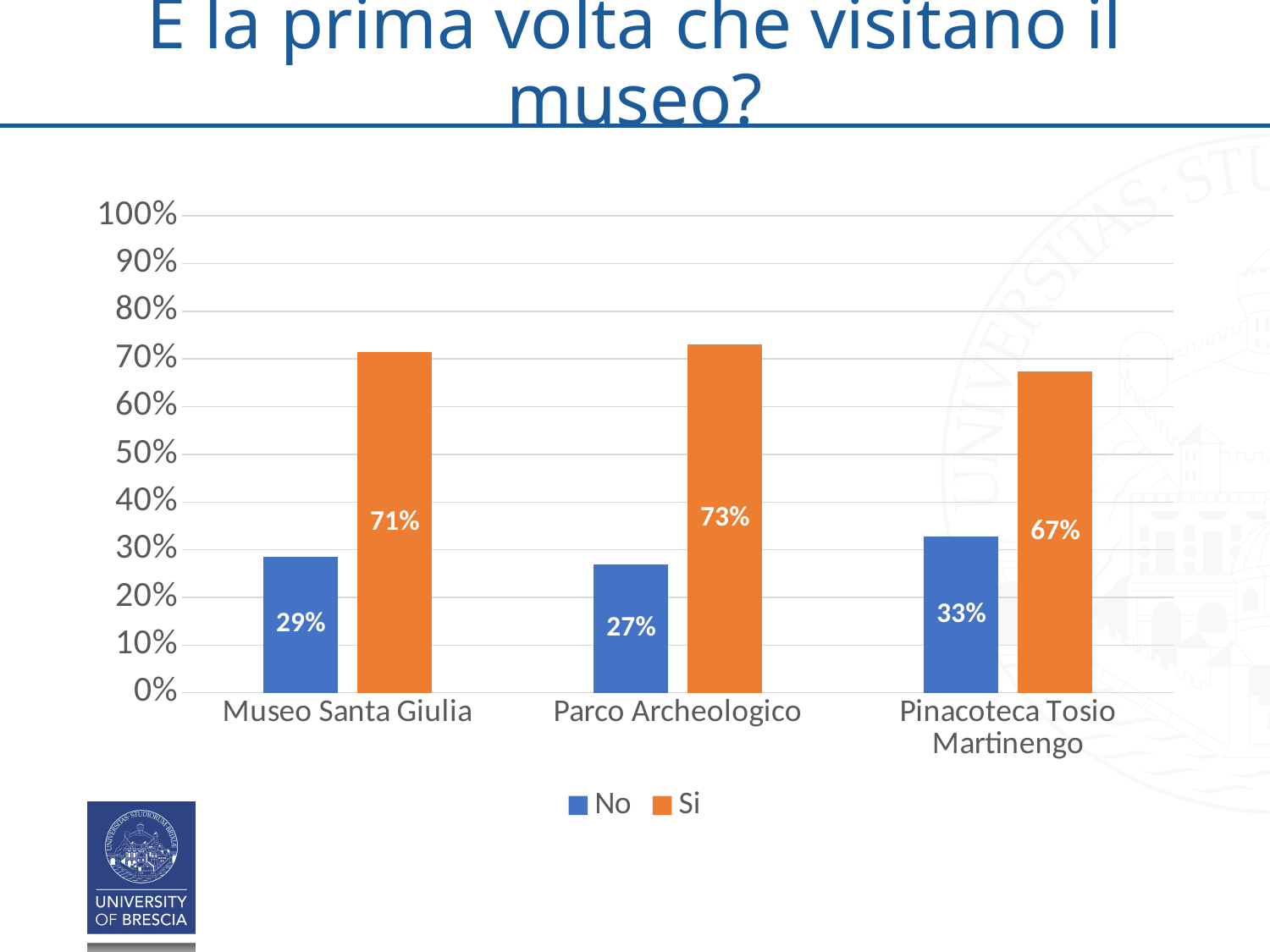
Which colour represents the 'Si' series? orange Which museum has the lowest 'No' value? Parco Archeologico What kind of chart is shown on the slide? bar chart Is the 'Si' value for Parco Archeologico greater or less than 60%? greater What is the 'No' value for Parco Archeologico? 27% How many museums are shown on the x axis? 3 How many series does the legend list? 2 What is the 'Si' value for Museo Santa Giulia? 71% Which is larger: the 'Si' value for Museo Santa Giulia or the 'Si' value for Pinacoteca Tosio Martinengo? Museo Santa Giulia What is the 'No' value for Pinacoteca Tosio Martinengo? 33% What is the difference between the 'Si' and 'No' values for Pinacoteca Tosio Martinengo? 34% Which museum has the highest 'Si' value? Parco Archeologico